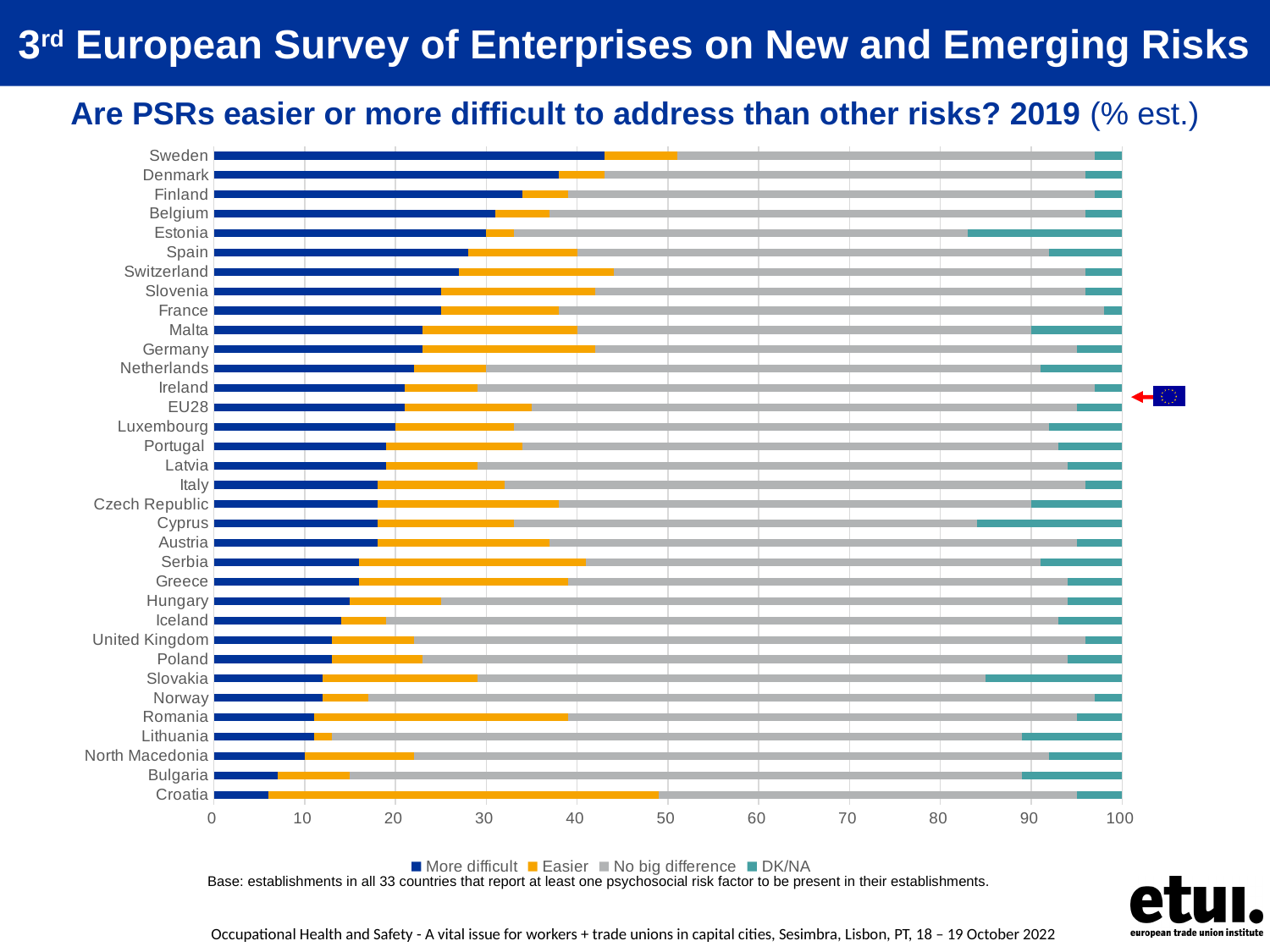
Do the 'More difficult' values rise or fall going from the top of the chart (Sweden) to the bottom (Croatia)? Fall Which series is shown in dark blue in the legend? More difficult What kind of chart is shown on the slide? Stacked bar chart Which has the larger 'More difficult' share, Finland or Poland? Finland Is the 'More difficult' value for Denmark greater or less than 40? less How many countries/regions are plotted on the chart? 34 Which has the larger 'Easier' share, Croatia or Lithuania? Croatia Which country has the highest 'More difficult' share? Sweden Is the 'More difficult' value for Sweden greater or less than 40? greater How many series does the legend list? 4 Which country has the lowest 'More difficult' share? Croatia Is the 'More difficult' value for Croatia greater or less than 10? less